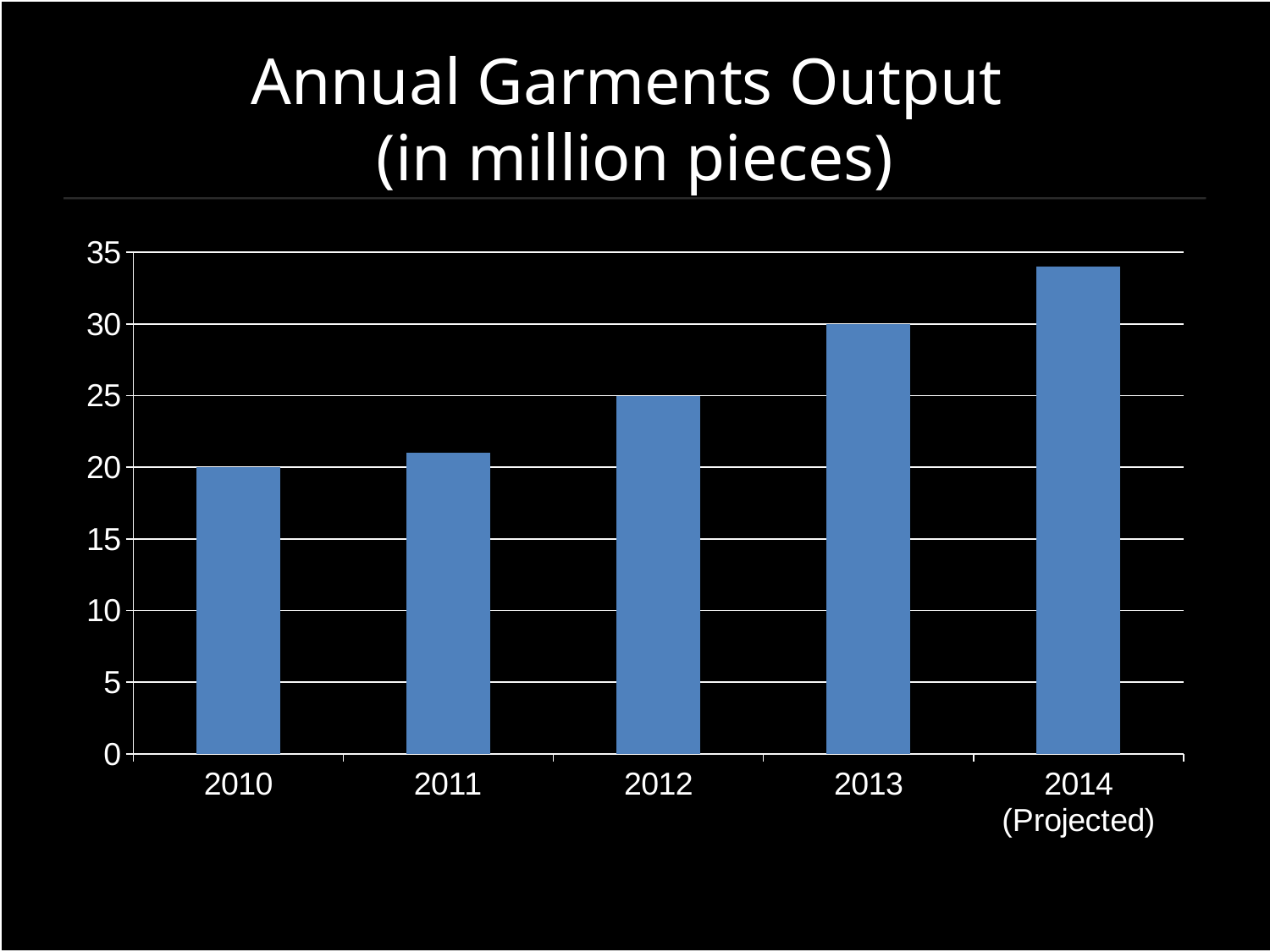
Which year has the highest output? 2014 (Projected) What is the value for 2013? 30 Is the value for 2014 (Projected) greater or less than 30? greater Which year has the lowest output? 2010 Is the value for 2011 greater or less than 25? less Which is larger, the value for 2012 or the value for 2011? 2012 What is the value for 2010? 20 What is the difference between the values for 2013 and 2010? 10 Do the values rise or fall from 2010 to 2014? rise What is the value for 2012? 25 What kind of chart is this? bar chart How many years are shown on the x axis? 5